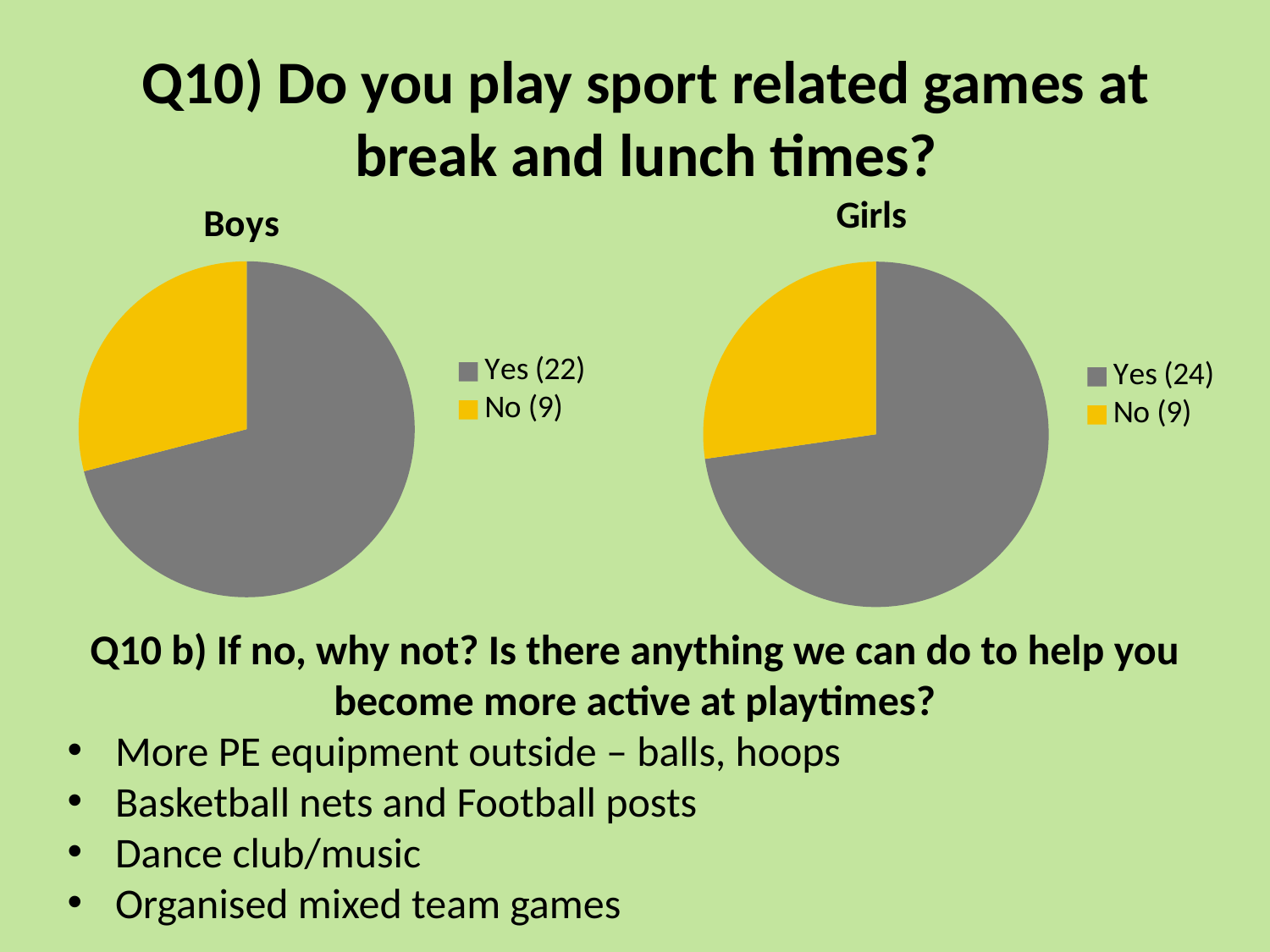
In the Girls chart, how many girls answered No? 9 How many slices does the Boys chart have? 2 In the Boys chart, which response has the larger slice? Yes In the Boys chart, how many boys answered Yes? 22 In the Girls chart, which response has the smaller slice? No Comparing the Yes slices, which chart has more Yes responses, Boys or Girls? Girls In the Boys chart, what is the difference between the number of Yes and No responses? 13 In the Girls chart, how many girls answered Yes? 24 What is the total number of responses shown in the Boys chart? 31 In the Girls chart, what colour is the No slice? Yellow What type of chart is used for the Boys and Girls data? Pie chart What is the total number of responses shown in the Girls chart? 33